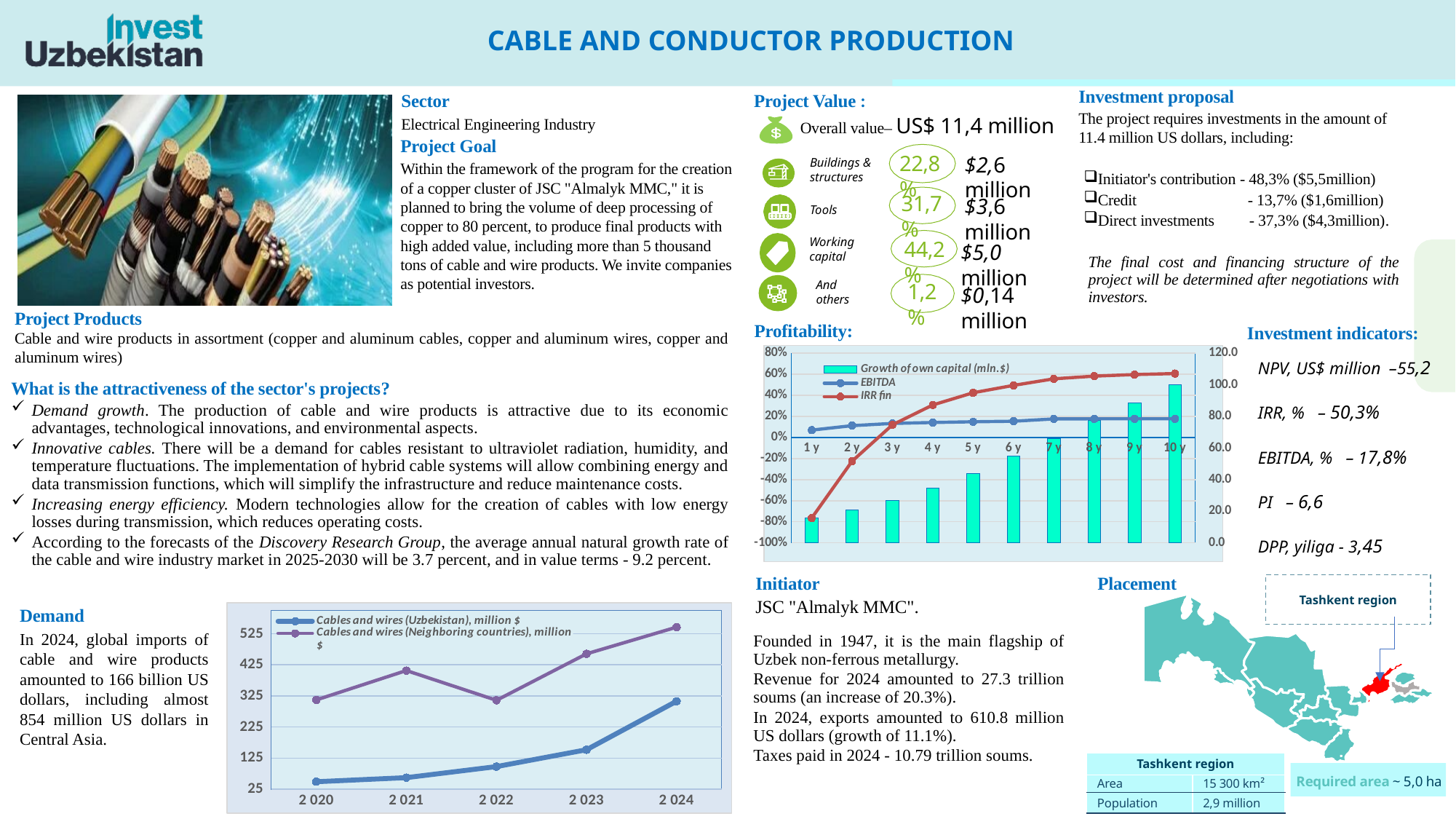
How many years are shown on the x axis of the Demand chart? 5 How many points are on the x axis of the Profitability chart? 10 How many series does the legend of the Profitability chart list? 3 In the Demand chart, is the value for Cables and wires (Uzbekistan) in 2024 greater or less than 225? greater In the Demand chart, which series is higher in 2024: Cables and wires (Uzbekistan) or Cables and wires (Neighboring countries)? Cables and wires (Neighboring countries) In the Demand chart, which year has the lowest value for Cables and wires (Uzbekistan)? 2020 In the Profitability chart, do the Growth of own capital bars rise or fall from 1 y to 10 y? rise In the Profitability chart, is the IRR fin value at 1 y greater or less than -60%? less In the Profitability chart, is the IRR fin value at 10 y greater or less than 40%? greater How many series does the legend of the Demand chart list? 2 In the Profitability chart, which year has the highest IRR fin value? 10 y What kind of chart is the Demand chart at the bottom of the slide? line chart